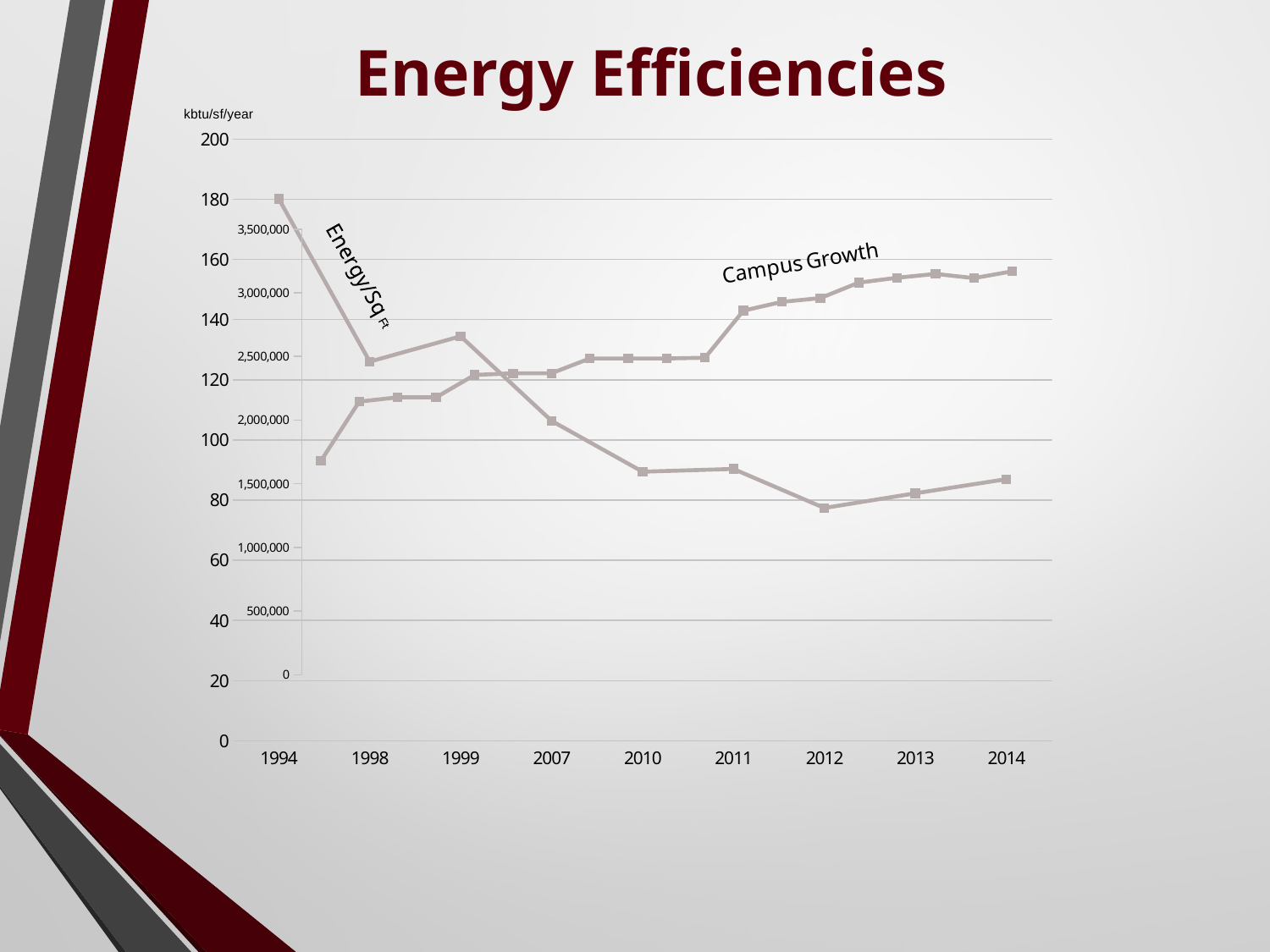
What unit label is shown above the left axis? kbtu/sf/year Is the Energy/Sq Ft value for 2010 greater or less than 100? less In which year is the Energy/Sq Ft series at its lowest? 2012 Does the Energy/Sq Ft series generally rise or fall from 1994 to 2014? fall What type of chart is shown on the slide? line chart What is the Energy/Sq Ft value for 1994? 180 Does the Campus Growth series generally rise or fall from 1994 to 2014? rise Is the Energy/Sq Ft value for 1998 greater or less than 120? greater How many data series are plotted on the chart? 2 In which year is the Energy/Sq Ft series at its highest? 1994 How many years are listed along the x axis? 9